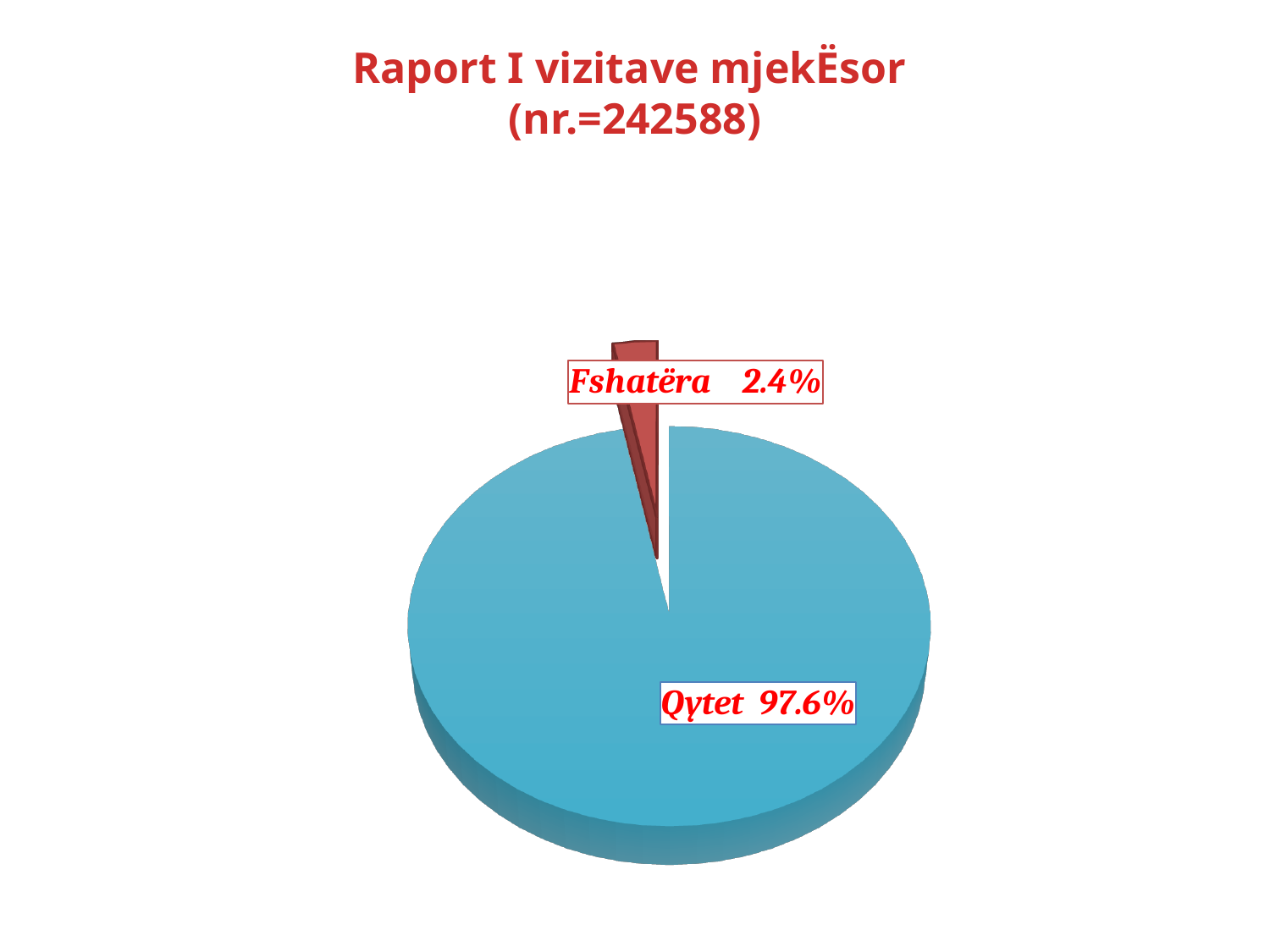
Which category has the smallest slice of the pie? Fshatëra What share of the pie does Fshatëra represent? 2.4% What is the total number (nr.) stated in the chart title? 242588 What is the title of the chart? Raport I vizitave mjekËsor (nr.=242588) How many slices does the pie chart have? 2 What is the difference in percentage points between the Qytet and Fshatëra slices? 95.2 What share of the pie does Qytet represent? 97.6% What kind of chart is shown on the slide? Pie chart What colour is the Fshatëra slice? Red Which slice is larger, Qytet or Fshatëra? Qytet Which category has the largest slice of the pie? Qytet